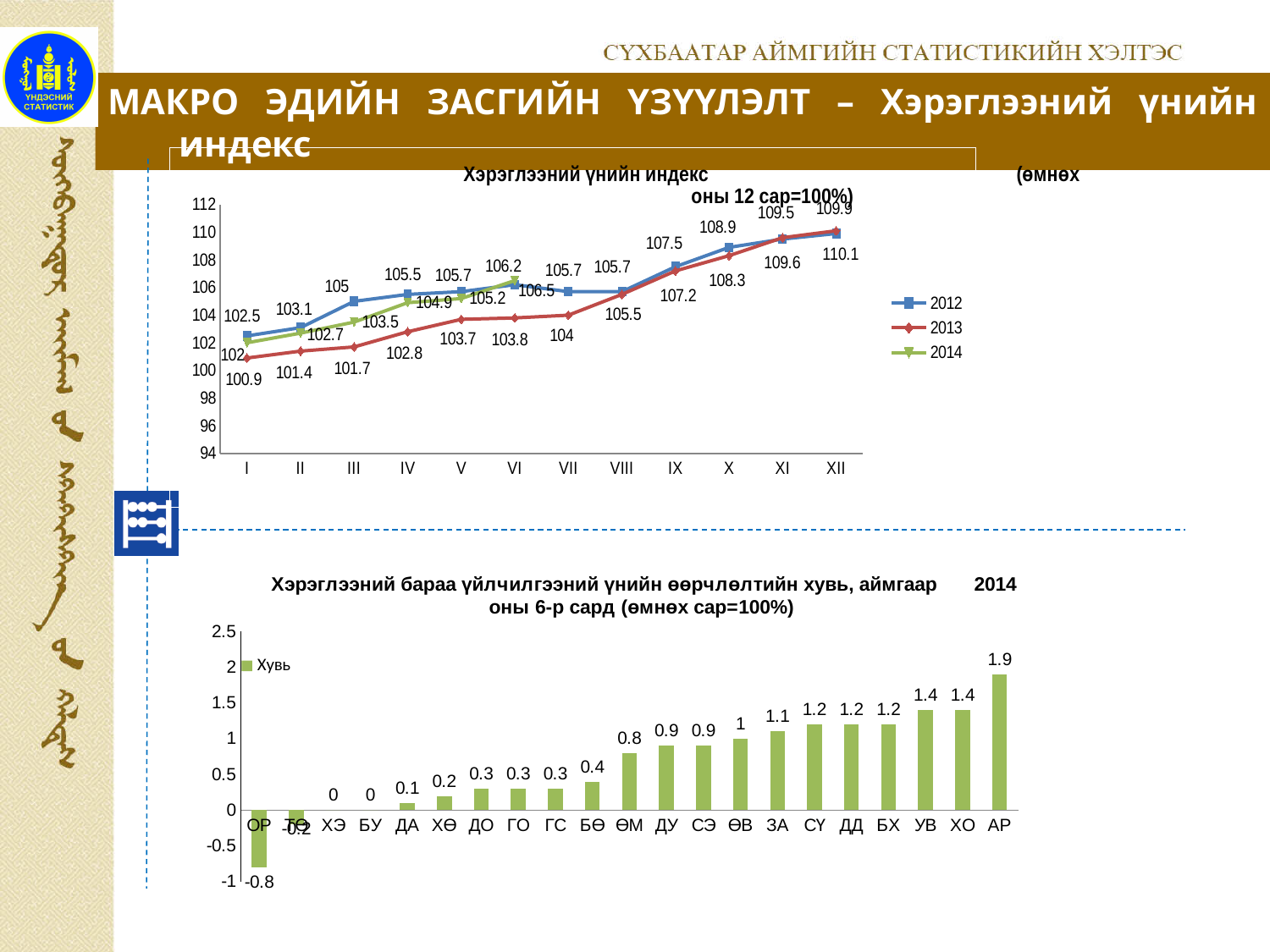
In the top chart (Хэрэглээний үнийн индекс), what is the difference between the 2013 and 2012 values for month XII? 0.2 In the bottom bar chart, which aimag has the lowest value? ОР In the top chart (Хэрэглээний үнийн индекс), what is the 2012 value for month XII? 109.9 What kind of chart is the top chart (Хэрэглээний үнийн индекс)? Line chart In the top chart (Хэрэглээний үнийн индекс), what is the 2013 value for month XII? 110.1 In the top chart (Хэрэглээний үнийн индекс), does the 2013 series rise or fall from month I to month XII? Rises In the bottom bar chart, which aimag has the highest value? АР In the bottom bar chart, how many aimags are shown on the x axis? 21 In the top chart (Хэрэглээний үнийн индекс), how many series does the legend list? 3 In the bottom bar chart, what is the value for ЗА? 1.1 In the top chart (Хэрэглээний үнийн индекс), what is the 2013 value for month I? 100.9 In the top chart (Хэрэглээний үнийн индекс), what is the 2014 value for month IV? 104.9